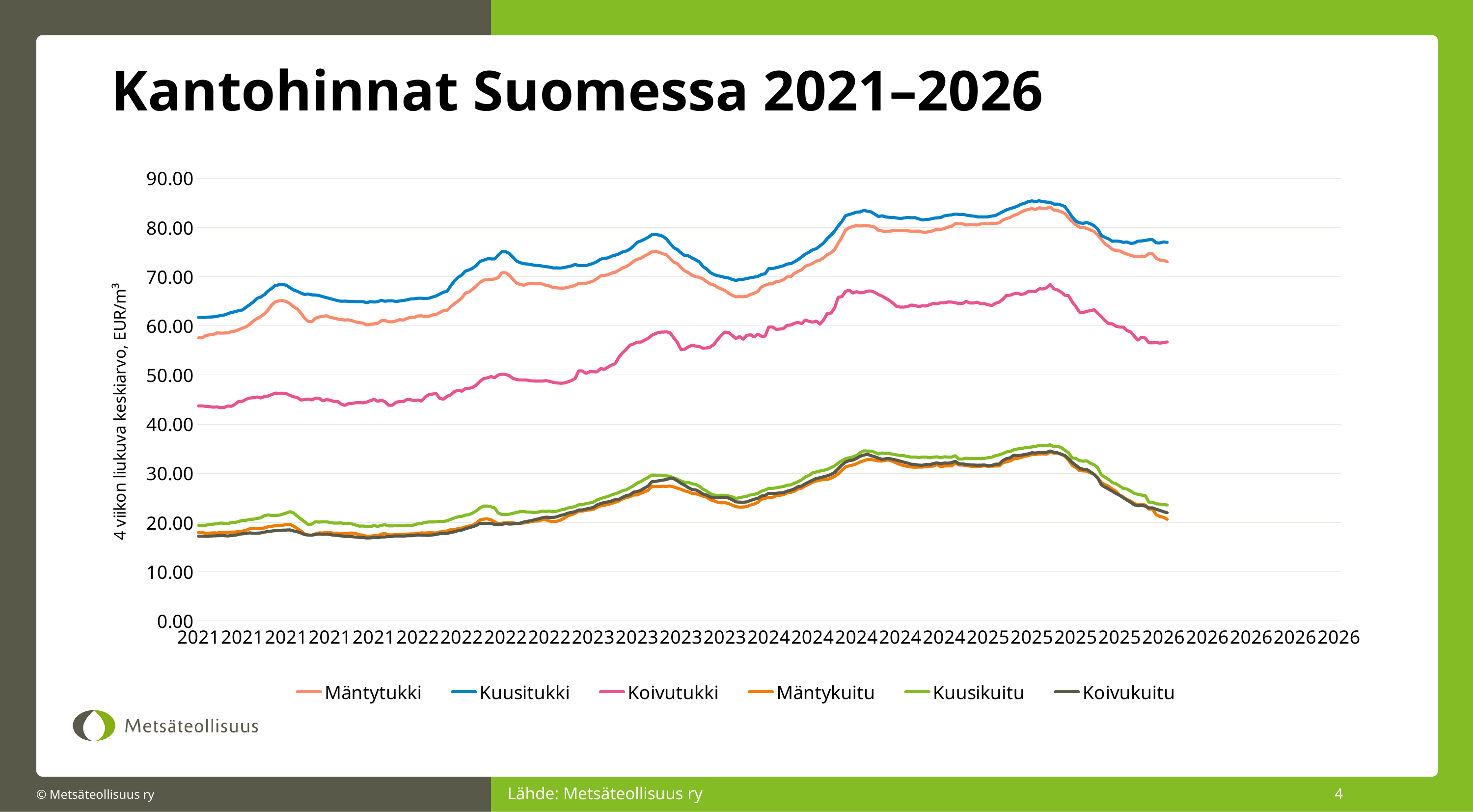
Which is larger in 2025, Koivutukki or Kuusikuitu? Koivutukki Is the value for Mäntytukki at the start of 2021 greater or less than 50.00? greater Is the peak value for Kuusitukki in 2025 greater or less than 80.00? greater What kind of chart is shown on the slide? line chart Does the Kuusitukki series rise or fall from its 2025 peak to the end of the plotted data in 2026? fall Is the value for Koivutukki at the start of 2021 greater or less than 50.00? less Which series has the highest values across the whole period? Kuusitukki How many series does the legend list? 6 What is the title of the chart? Kantohinnat Suomessa 2021–2026 What is the label of the vertical axis? 4 viikon liukuva keskiarvo, EUR/m³ Does the Koivutukki series rise or fall from 2021 to its 2025 peak? rise